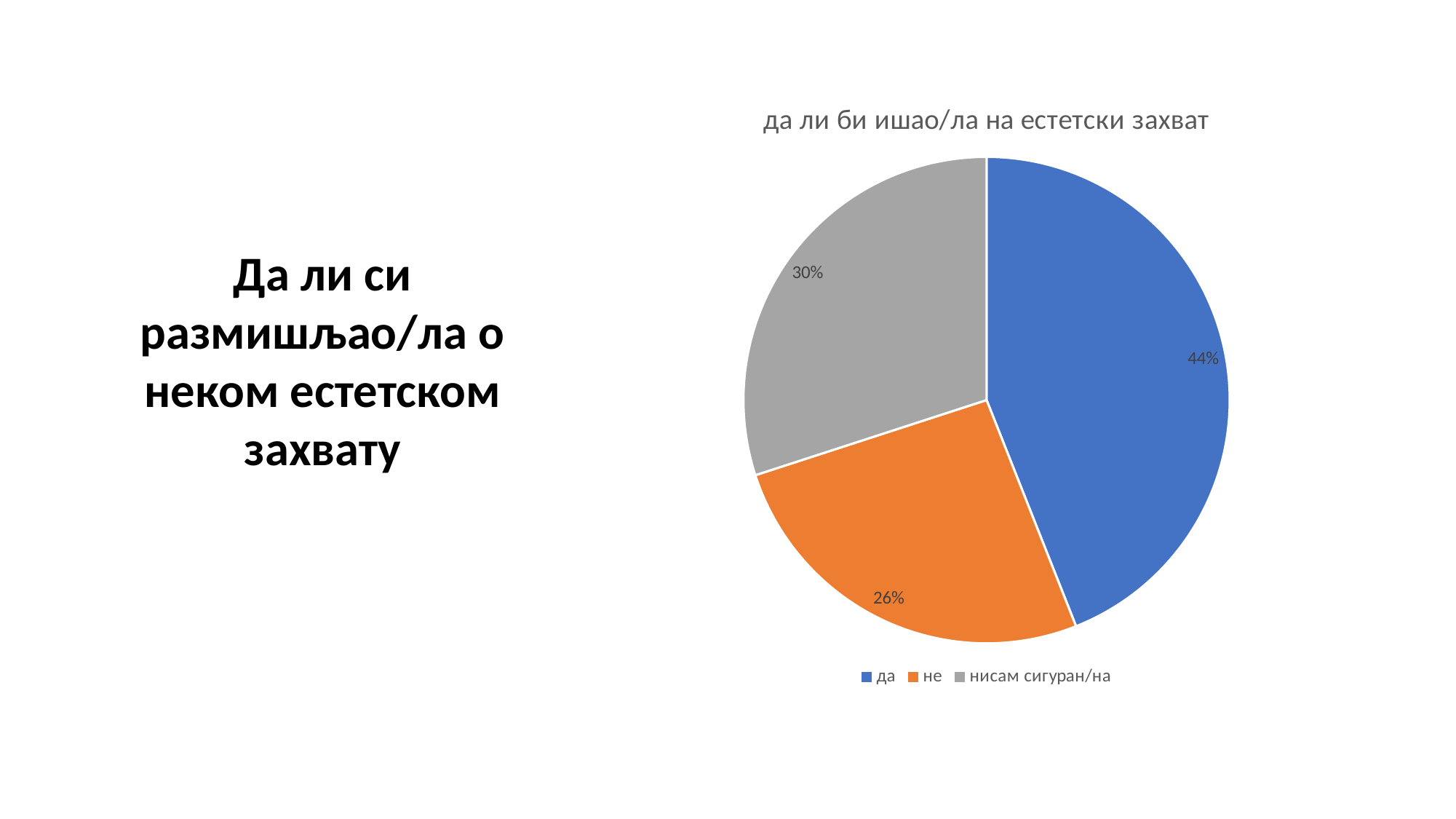
Which slice is larger, 'не' or 'нисам сигуран/на'? нисам сигуран/на What colour is the 'не' slice? orange What is the difference in percentage points between the 'нисам сигуран/на' and 'не' slices? 4 Which category has the largest share of the pie? да What is the title of the chart? да ли би ишао/ла на естетски захват How many categories does the legend list? 3 What type of chart is shown on the slide? pie chart What percentage of the pie is the 'да' slice? 44% What percentage of the pie is the 'не' slice? 26% What is the difference in percentage points between the 'да' and 'не' slices? 18 What percentage of the pie is the 'нисам сигуран/на' slice? 30% Which category has the smallest share of the pie? не